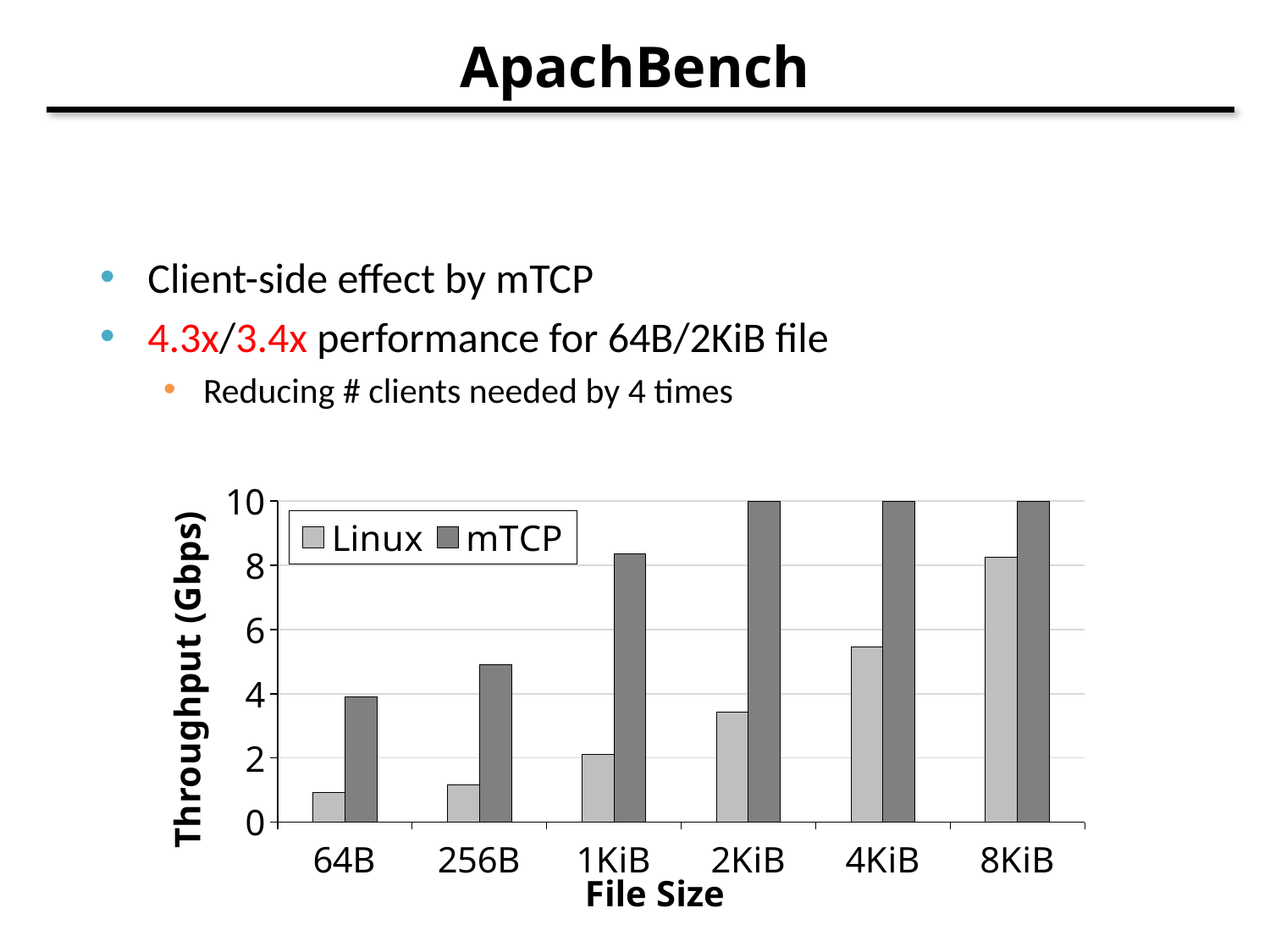
How many series does the legend list? 2 What is the label of the y axis? Throughput (Gbps) What kind of chart is shown on the slide? bar chart Which two series are listed in the legend? Linux and mTCP Is the Linux throughput for 64B greater or less than 2? less For the 2KiB file size, which series has the higher throughput, Linux or mTCP? mTCP For which file size is the Linux throughput highest? 8KiB Is the Linux throughput for 4KiB greater or less than 6? less Is the mTCP throughput for 1KiB greater or less than 8? greater Does the Linux throughput rise or fall as file size increases from 64B to 8KiB? rise How many file size categories are shown on the x axis? 6